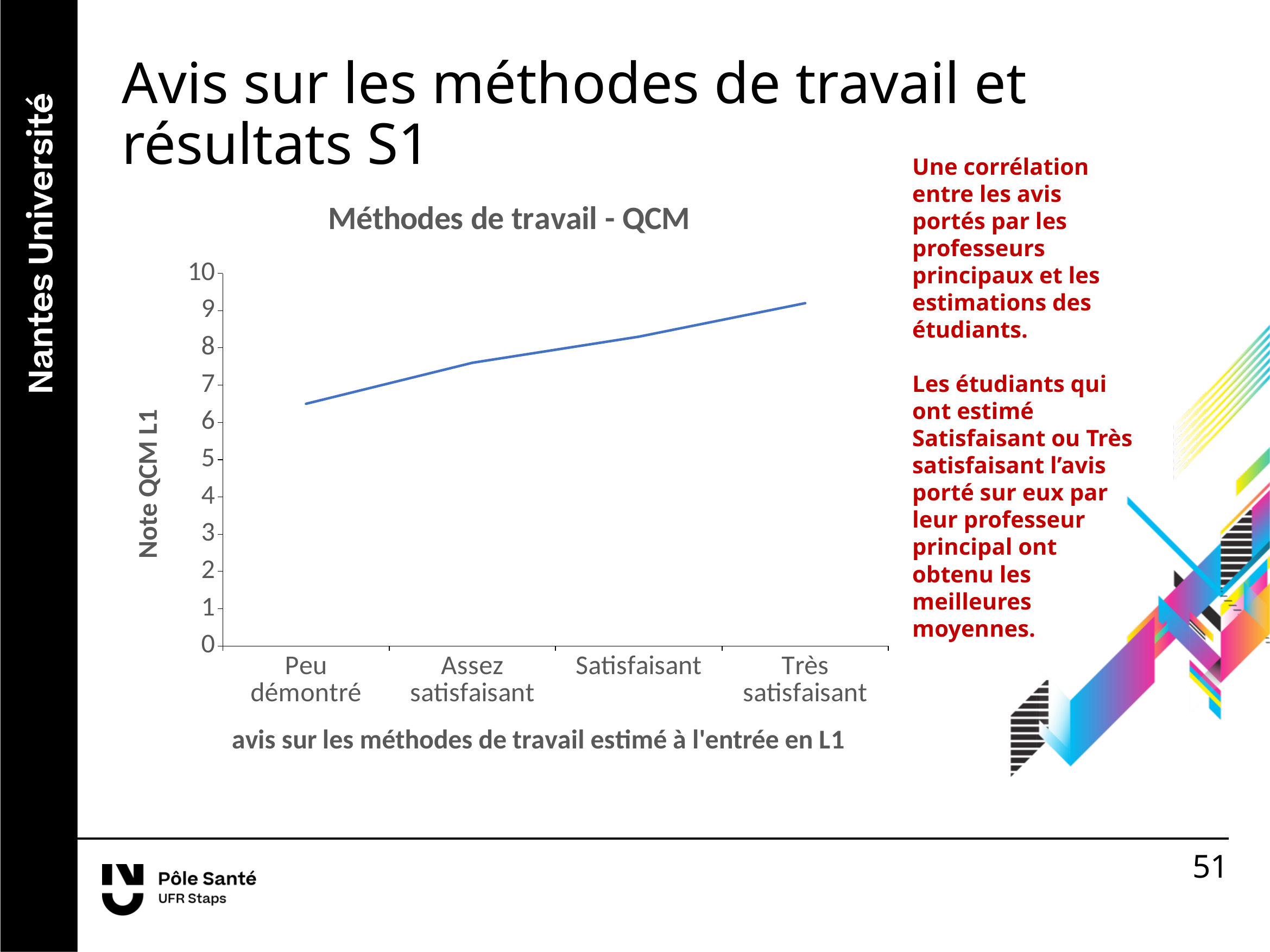
Which category has the lowest Note QCM L1 value? Peu démontré Which category has the highest Note QCM L1 value? Très satisfaisant Which is larger, the value for Assez satisfaisant or the value for Satisfaisant? Satisfaisant What kind of chart is shown on the slide? line chart What is the title of the chart? Méthodes de travail - QCM How many categories are plotted along the x axis of the chart? 4 Is the value for Assez satisfaisant greater or less than 7? greater Is the value for Peu démontré greater or less than 6? greater Do the values rise or fall from Peu démontré to Très satisfaisant along the x axis? rise Is the value for Peu démontré greater or less than 7? less